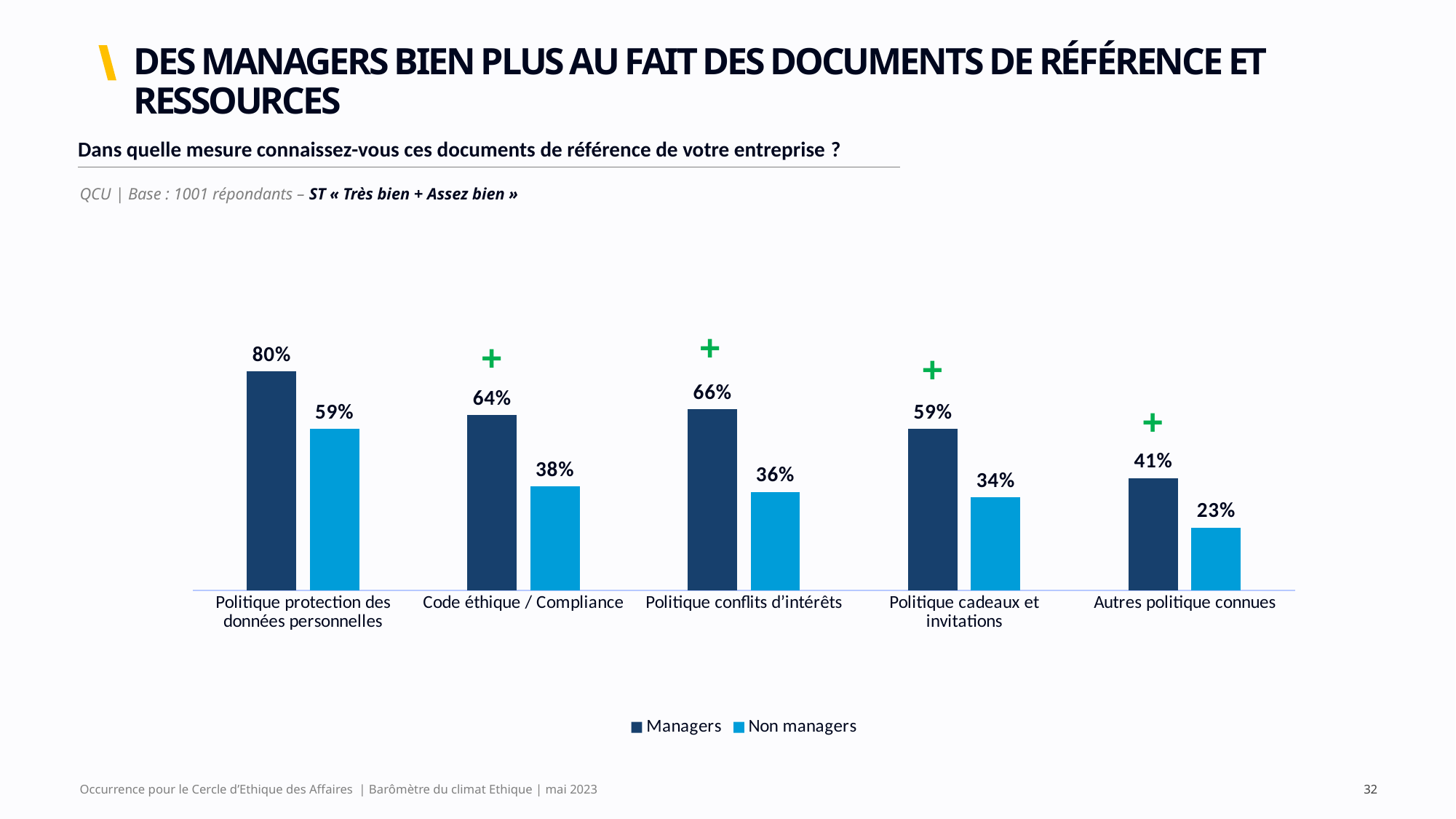
Which category has the highest value for Managers? Politique protection des données personnelles What is the value for Non managers for "Code éthique / Compliance"? 38% How many categories are shown on the x axis? 5 What is the value for Managers for "Politique conflits d'intérêts"? 66% What are the two series named in the legend? Managers and Non managers What is the value for Non managers for "Autres politique connues"? 23% What is the difference between the Managers and Non managers values for "Politique cadeaux et invitations"? 25 percentage points Which category has the lowest value for Non managers? Autres politique connues What kind of chart is shown on the slide? Bar chart How many series does the legend list? 2 What is the value for Managers for "Politique protection des données personnelles"? 80% Which is larger: the Managers value for "Code éthique / Compliance" or the Managers value for "Politique conflits d'intérêts"? Politique conflits d'intérêts